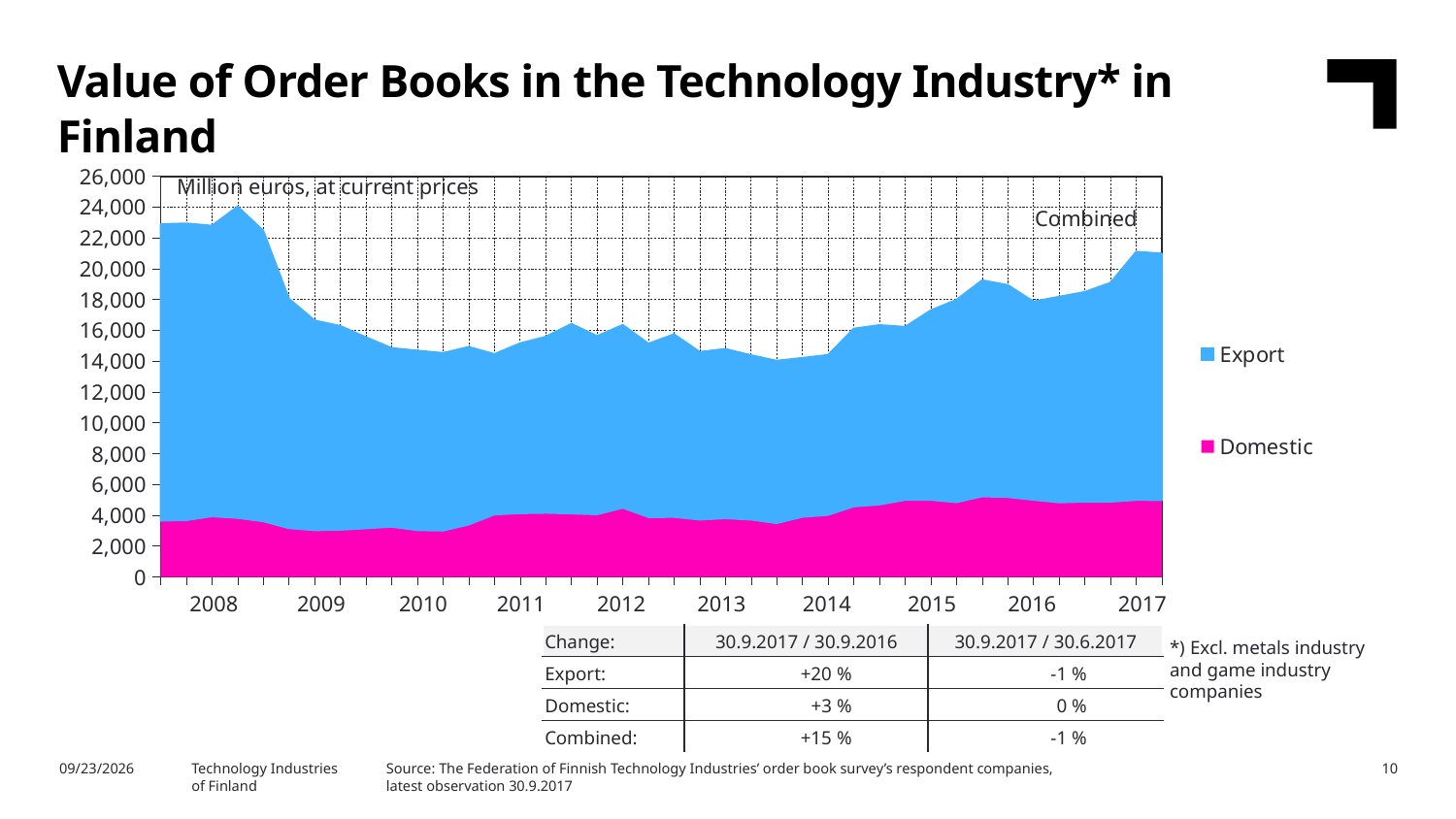
According to the table, what is the Export change for 30.9.2017 / 30.9.2016? +20 % According to the table, what is the Combined change for 30.9.2017 / 30.6.2017? -1 % How many series does the chart legend list? 2 Does the combined value of order books rise or fall from 2008 to 2010? fall Which two series are listed in the chart legend? Export and Domestic What unit is stated for the values in the chart? Million euros, at current prices Which series is larger in 2017, Export or Domestic? Export Is the Domestic value in 2017 greater or less than 6,000? less Is the combined value of order books at the start of 2008 greater or less than 22,000? greater What kind of chart is shown on the slide? Stacked area chart Is the combined value of order books at the end of 2017 greater or less than 20,000? greater